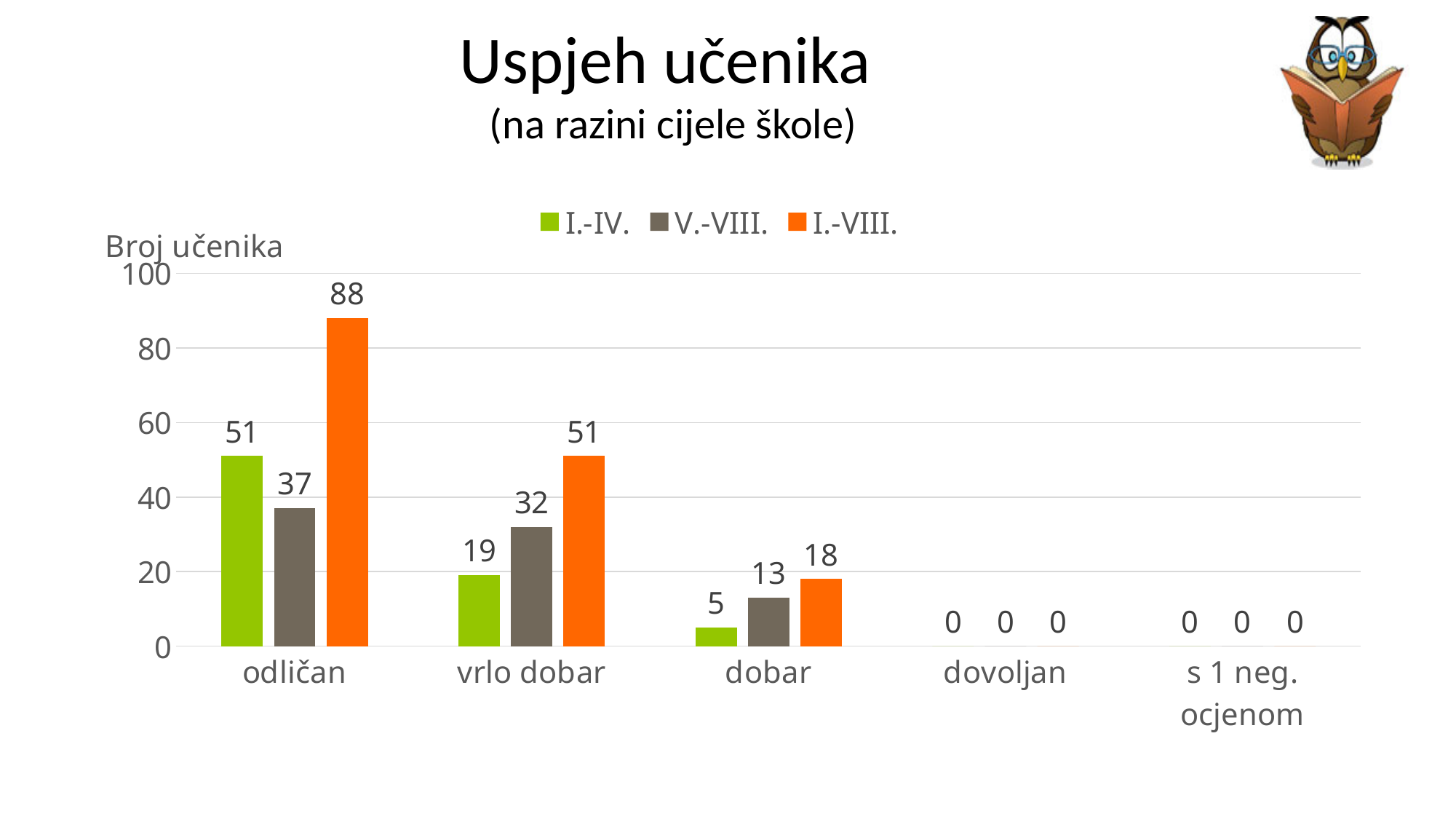
What is the difference between the V.-VIII. and I.-IV. values in the vrlo dobar category? 13 How many categories are shown on the x axis? 5 What kind of chart is shown on the slide? bar chart What is the difference between the I.-VIII. and I.-IV. values in the odličan category? 37 What is the value for V.-VIII. in the vrlo dobar category? 32 What is the value for I.-IV. in the dobar category? 5 What is the label of the vertical axis? Broj učenika Which is larger in the vrlo dobar category: I.-IV. or V.-VIII.? V.-VIII. How many series does the legend list? 3 Which category has the highest value for the I.-VIII. series? odličan Do the I.-VIII. values rise or fall from odličan to dobar? fall What is the value for I.-VIII. in the odličan category? 88